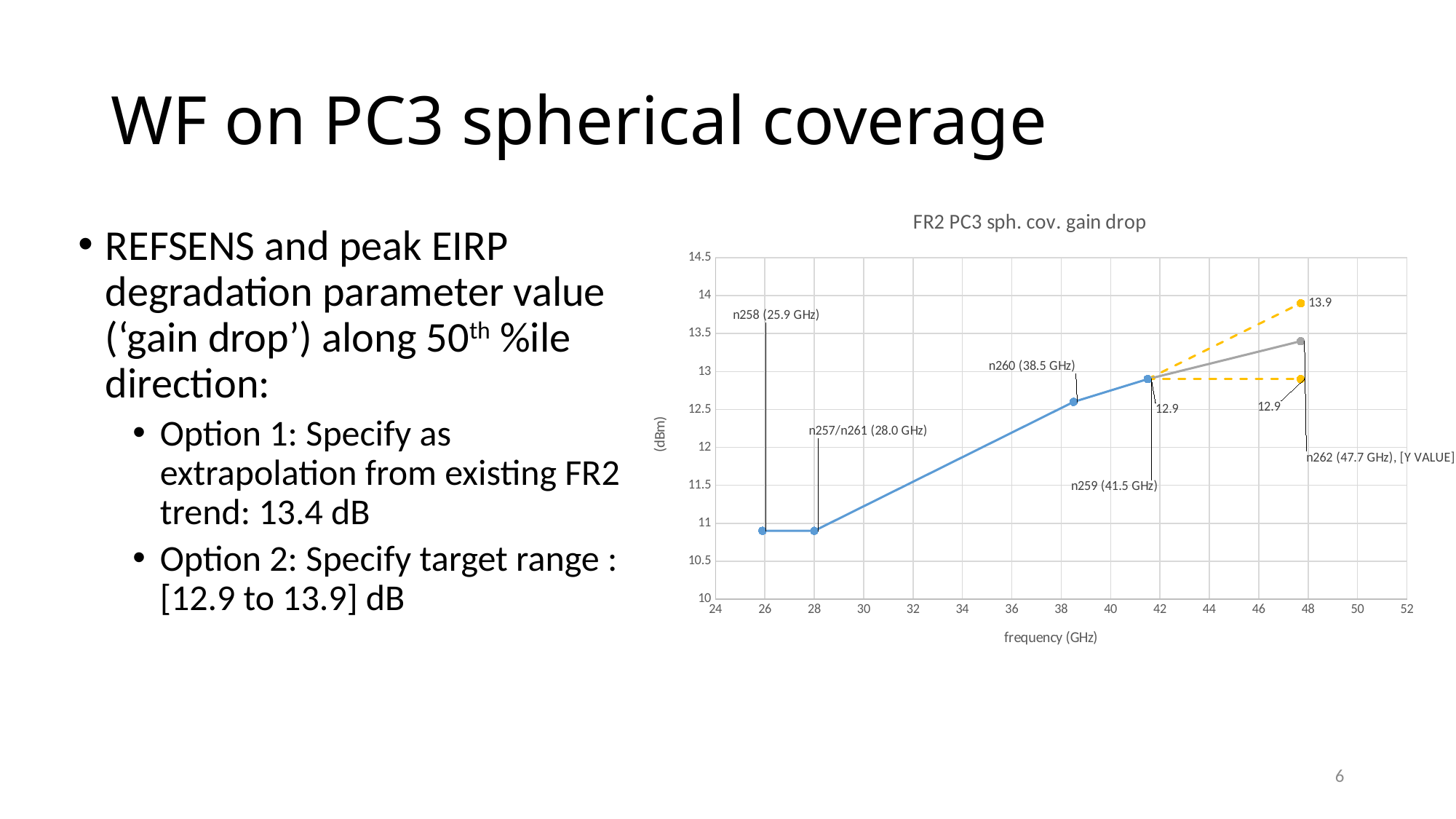
Is the value for n258 (25.9 GHz) greater or less than 12? less What is the title of the chart? FR2 PC3 sph. cov. gain drop What kind of chart is shown on the slide? line chart What value is labeled at the upper yellow dashed endpoint at 47.7 GHz? 13.9 What value is labeled at the n259 (41.5 GHz) point? 12.9 What is the label of the x axis of the chart? frequency (GHz) Which has the larger value, n260 (38.5 GHz) or n259 (41.5 GHz)? n259 (41.5 GHz) What is the difference between the upper (13.9) and lower (12.9) yellow dashed endpoints at 47.7 GHz? 1.0 Is the value of the gray line endpoint at n262 (47.7 GHz) greater or less than 13? greater Do the values along the blue line rise or fall as frequency increases? rise How many data points are plotted on the blue solid line? 4 Is the value for n260 (38.5 GHz) greater or less than 12? greater